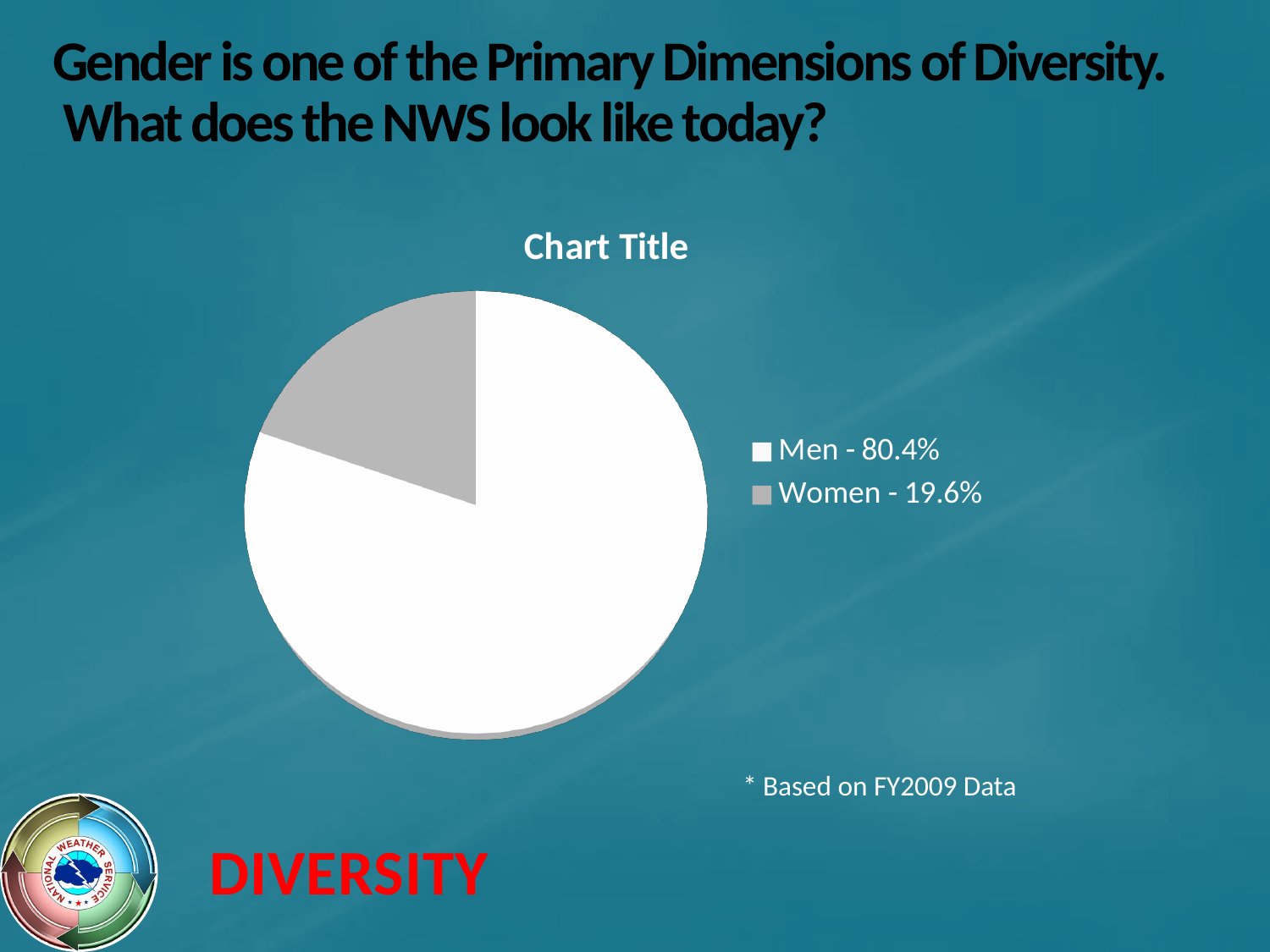
What kind of chart is shown on the slide? pie chart What percentage of the pie is Men? 80.4% What colour is the Women slice of the pie? grey How many entries does the legend list? 2 Which is larger, the Men slice or the Women slice? Men What is the share of the pie taken by the Women slice? 19.6% What is the title shown above the pie chart? Chart Title What percentage of the pie is Women? 19.6% How many slices does the pie chart have? 2 What is the difference in percentage points between the Men and Women slices? 60.8 Which slice of the pie is the largest? Men Which slice of the pie is the smallest? Women